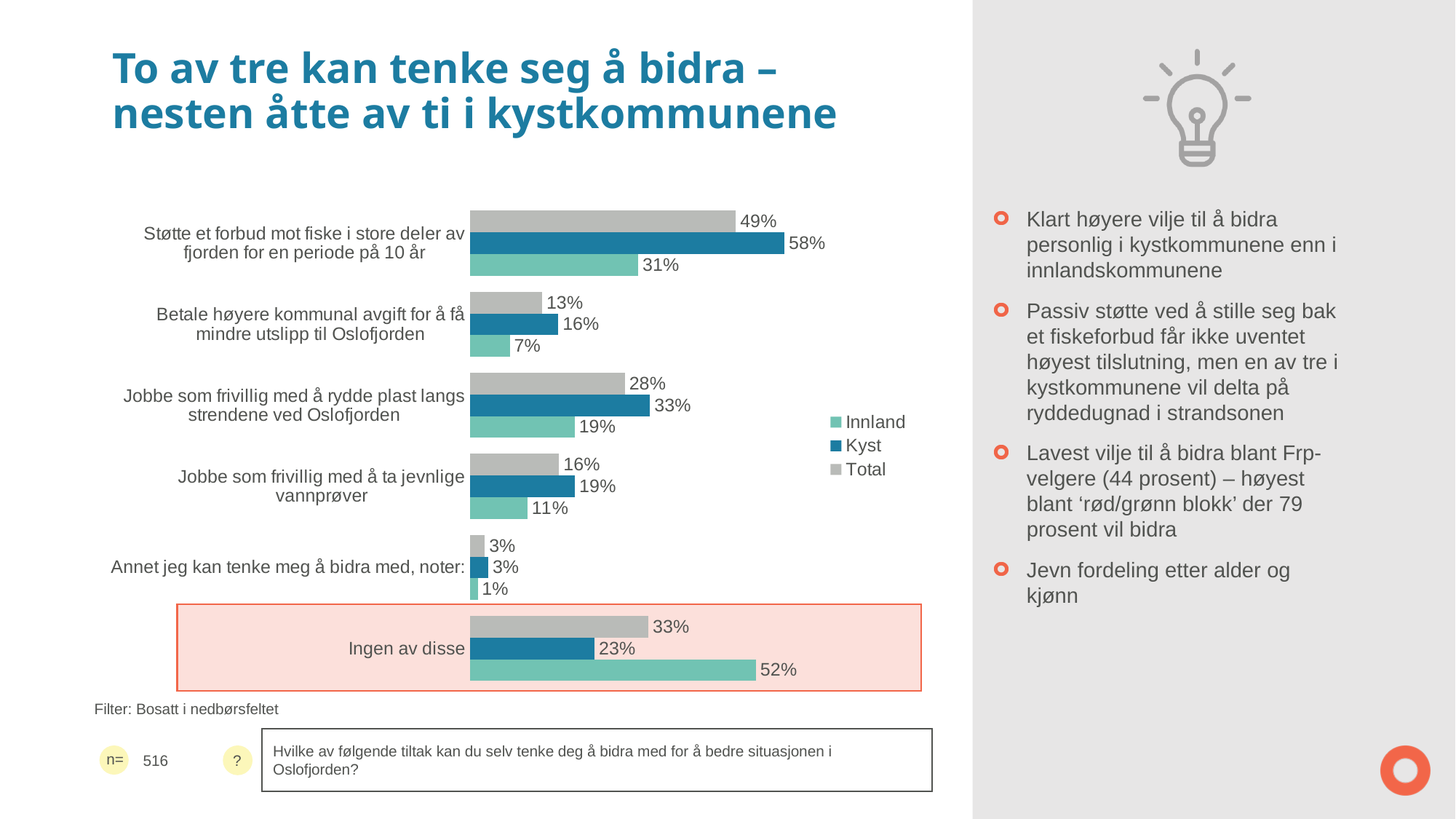
What is the Total value for "Jobbe som frivillig med å rydde plast langs strendene ved Oslofjorden"? 28% What is the Innland value for "Ingen av disse"? 52% What kind of chart is shown on the slide? Bar chart Which category is highlighted with a red box in the chart? Ingen av disse What is the Innland value for "Betale høyere kommunal avgift for å få mindre utslipp til Oslofjorden"? 7% How many categories are shown in the chart? 6 How many series does the legend list? 3 Which category has the highest Kyst value? Støtte et forbud mot fiske i store deler av fjorden for en periode på 10 år What is the difference between the Kyst and Innland values for "Støtte et forbud mot fiske i store deler av fjorden for en periode på 10 år"? 27 percentage points What is the Kyst value for "Støtte et forbud mot fiske i store deler av fjorden for en periode på 10 år"? 58% Which is larger for "Ingen av disse": the Innland value or the Kyst value? Innland Which category has the lowest Total value? Annet jeg kan tenke meg å bidra med, noter: